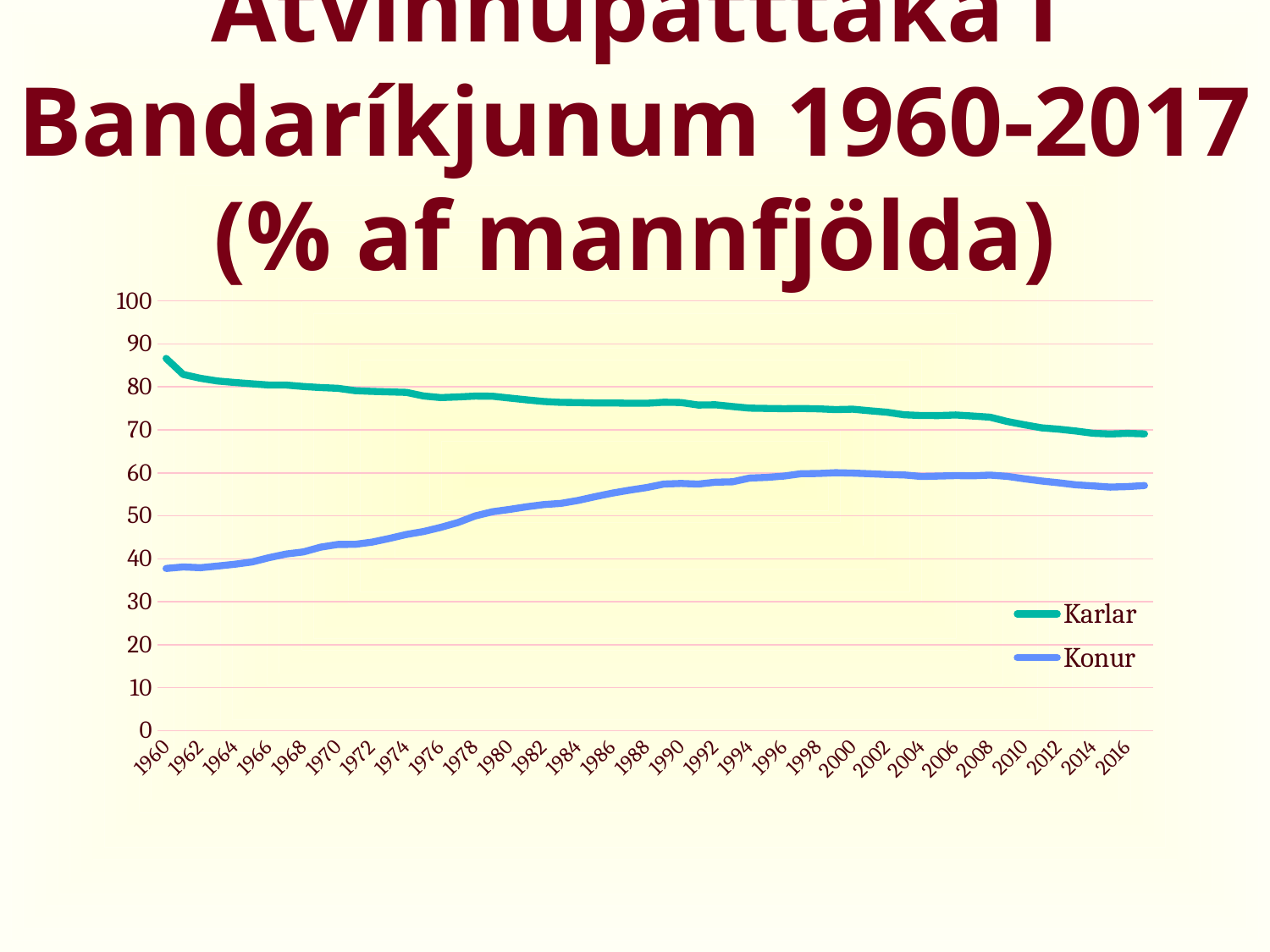
Is the value for Karlar in 1960 greater or less than 80? greater Is the value for Karlar in 2016 greater or less than 80? less Which series has the larger value in 1980, Karlar or Konur? Karlar Do the values for Karlar rise or fall from 1960 to 2016? fall Is the value for Konur in 1960 greater or less than 50? less Which series is drawn in green? Karlar What kind of chart is shown on the slide? line chart Which series has the lower value in 2016, Karlar or Konur? Konur Do the values for Konur rise or fall from 1960 to 2000? rise How many series does the legend list? 2 What are the two series named in the legend? Karlar and Konur